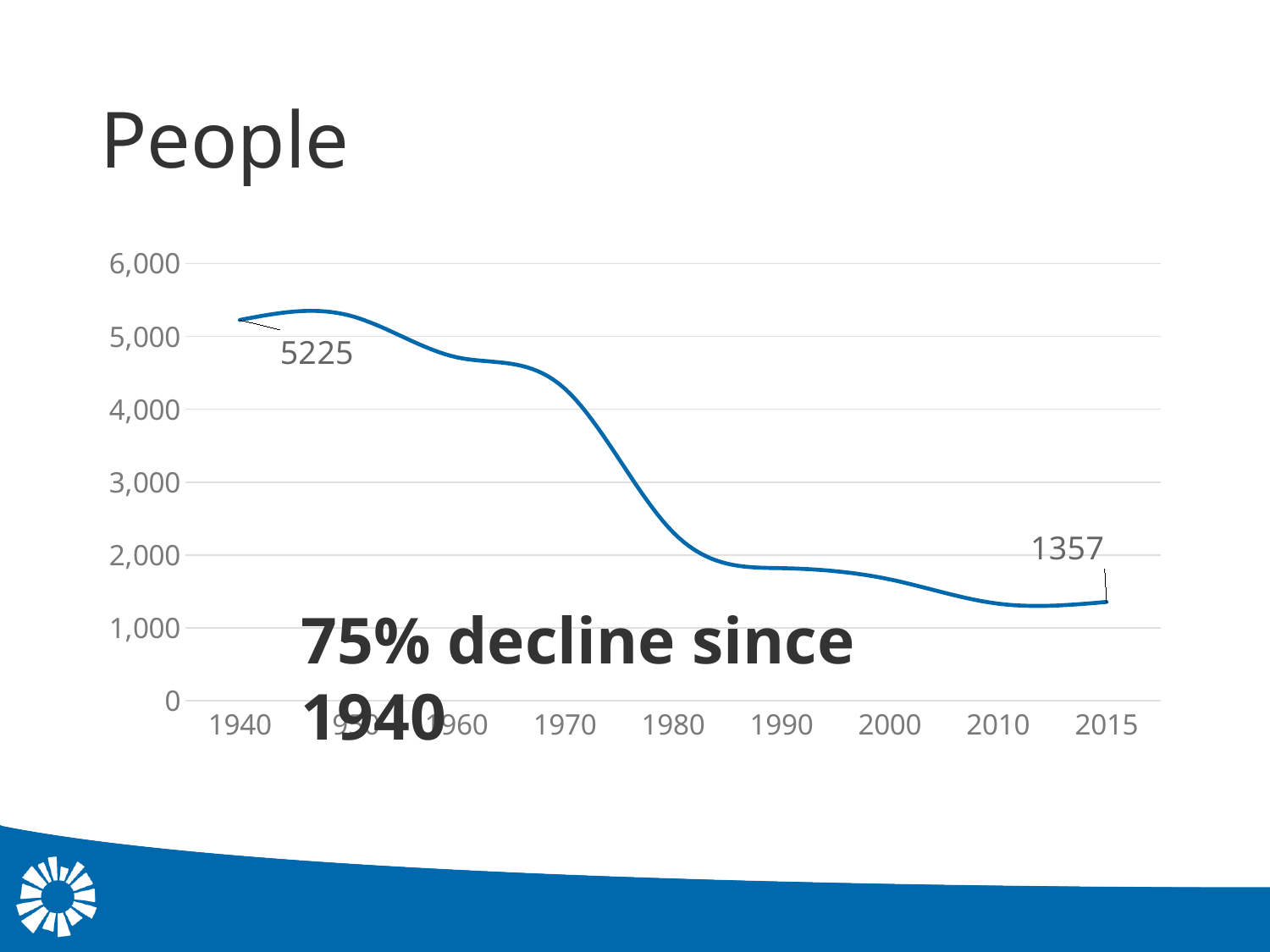
What kind of chart is shown on the slide? line chart What does the text annotation on the chart say? 75% decline since 1940 Is the value for 1970 greater or less than 4,000? greater Is the value for 2010 greater or less than 2,000? less What is the title of the chart? People Which is larger, the value for 1940 or the value for 2015? 1940 What is the value for 2015? 1357 Do the values generally rise or fall from 1940 to 2015? fall Is the value for 1990 greater or less than 3,000? less What is the value for 1940? 5225 What is the difference between the value for 1940 and the value for 2015? 3868